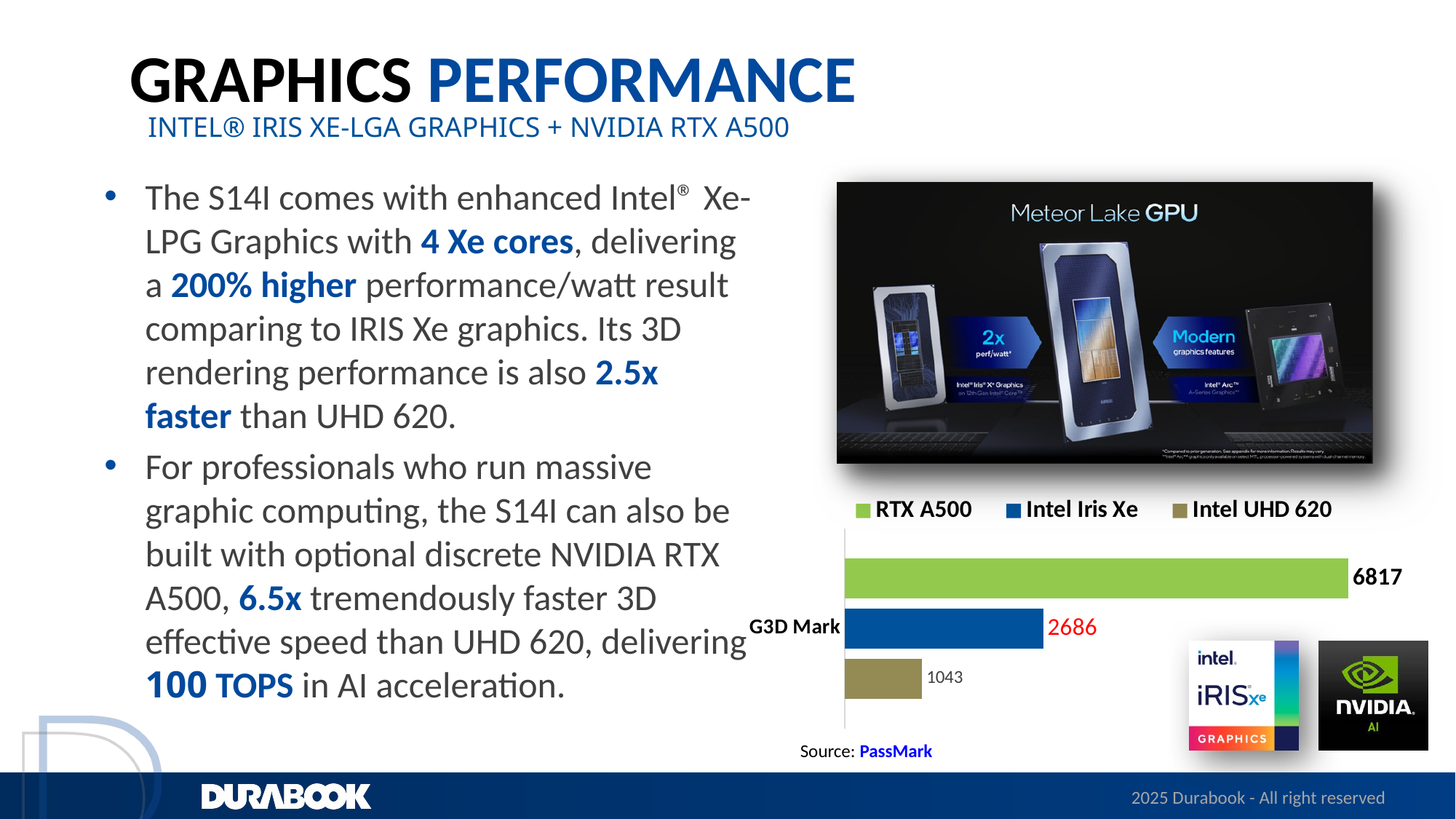
What is the category label on the chart's axis? G3D Mark What colour is the bar for the RTX A500? Green What is the difference between the G3D Mark scores of the RTX A500 and Intel Iris Xe? 4131 What is the difference between the G3D Mark scores of Intel Iris Xe and Intel UHD 620? 1643 Which series has the lowest G3D Mark score? Intel UHD 620 How many series does the chart legend list? 3 What is the G3D Mark value for Intel UHD 620? 1043 What is the G3D Mark value for Intel Iris Xe? 2686 Which series has the highest G3D Mark score? RTX A500 Which has a higher G3D Mark score, Intel Iris Xe or Intel UHD 620? Intel Iris Xe What is the G3D Mark value for the RTX A500? 6817 What kind of chart is shown on the slide? Bar chart